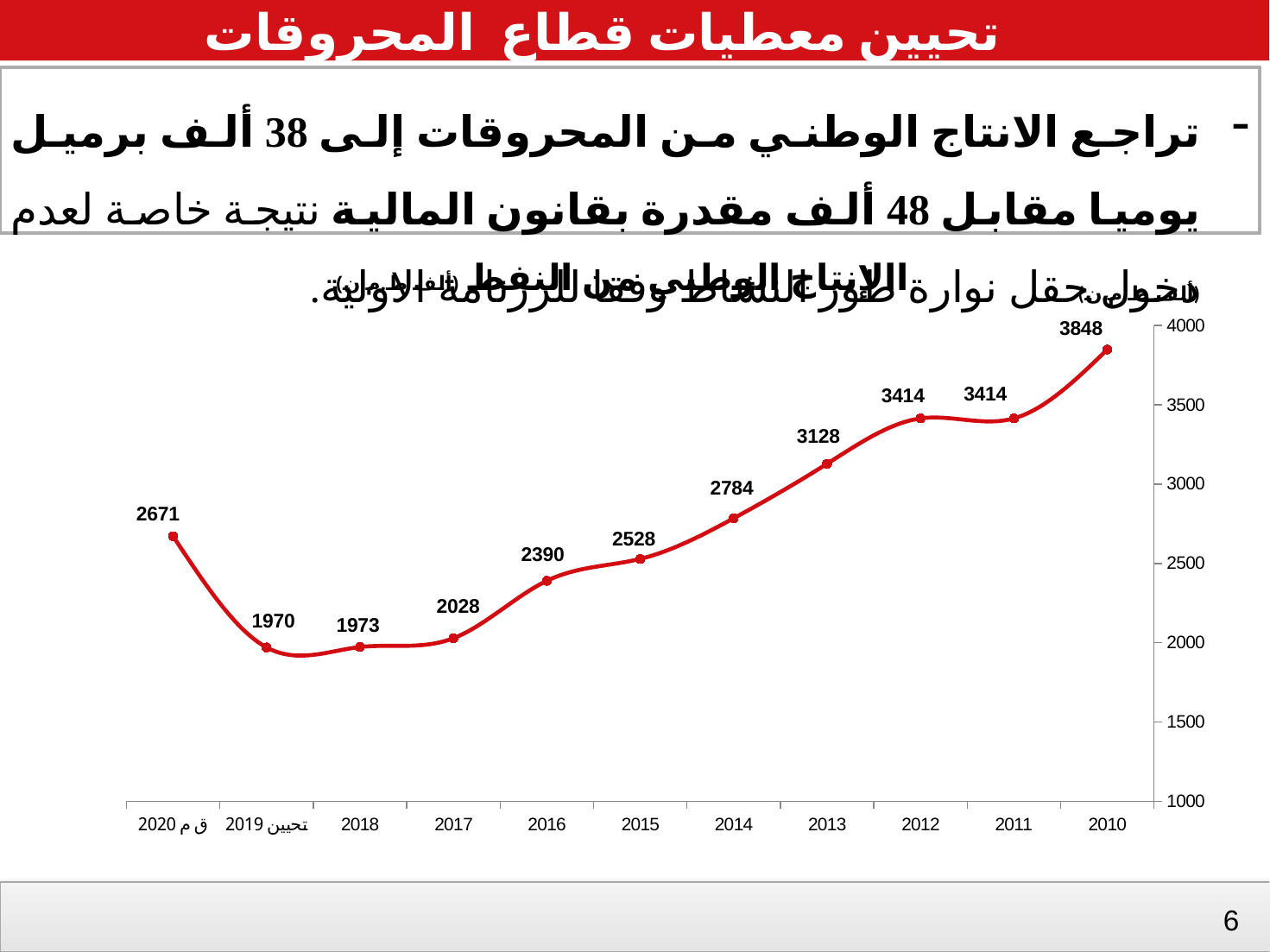
Do the values rise or fall from 2010 to 2018? fall Which is larger, the value for 2013 or the value for 2014? 2013 What is the value for 2016? 2390 How many data points are plotted on the chart? 11 Which year has the highest value? 2010 What is the difference between the values for ق م 2020 and 2018? 698 What is the value for 2010? 3848 What is the difference between the values for 2010 and 2011? 434 What is the value for ق م 2020? 2671 What is the value for تحيين 2019? 1970 Which year has the lowest value? تحيين 2019 What type of chart is shown on the slide? line chart